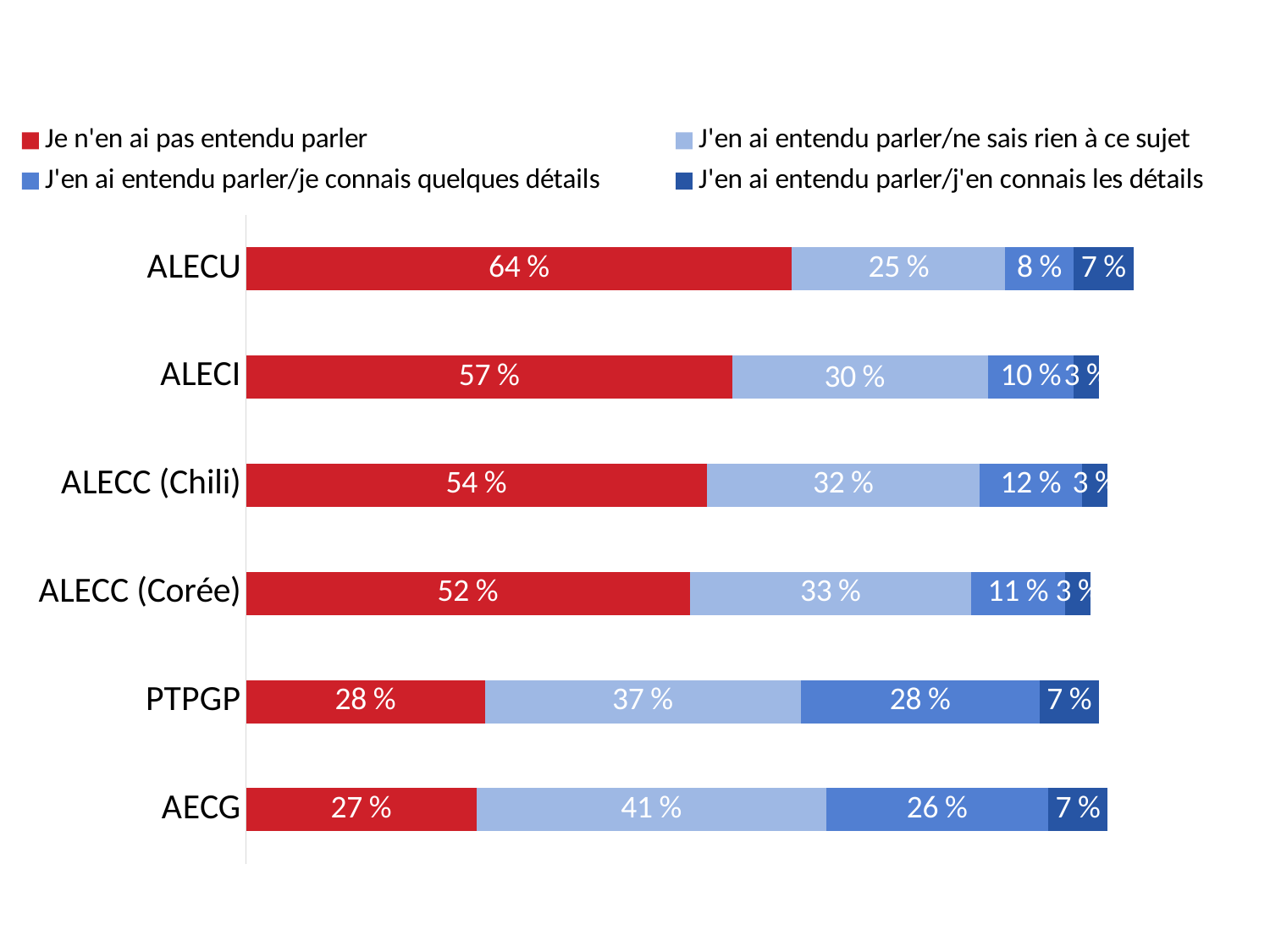
Which agreement has the highest value for "Je n'en ai pas entendu parler"? ALECU Which agreement has the lowest value for "Je n'en ai pas entendu parler"? AECG How many agreements (categories) are shown in the chart? 6 What is the value for PTPGP in the series "J'en ai entendu parler/j'en connais les détails"? 7 % How many series does the legend list? 4 What is the value for AECG in the series "J'en ai entendu parler/ne sais rien à ce sujet"? 41 % What colour represents the series "Je n'en ai pas entendu parler"? Red What is the difference between ALECU and AECG in the series "Je n'en ai pas entendu parler"? 37 % What percentage of respondents for ALECU answered "Je n'en ai pas entendu parler"? 64 % What is the total of the stacked bar for ALECI? 100 % Which has a larger value for "J'en ai entendu parler/je connais quelques détails": PTPGP or ALECI? PTPGP What kind of chart is shown on the slide? Stacked bar chart